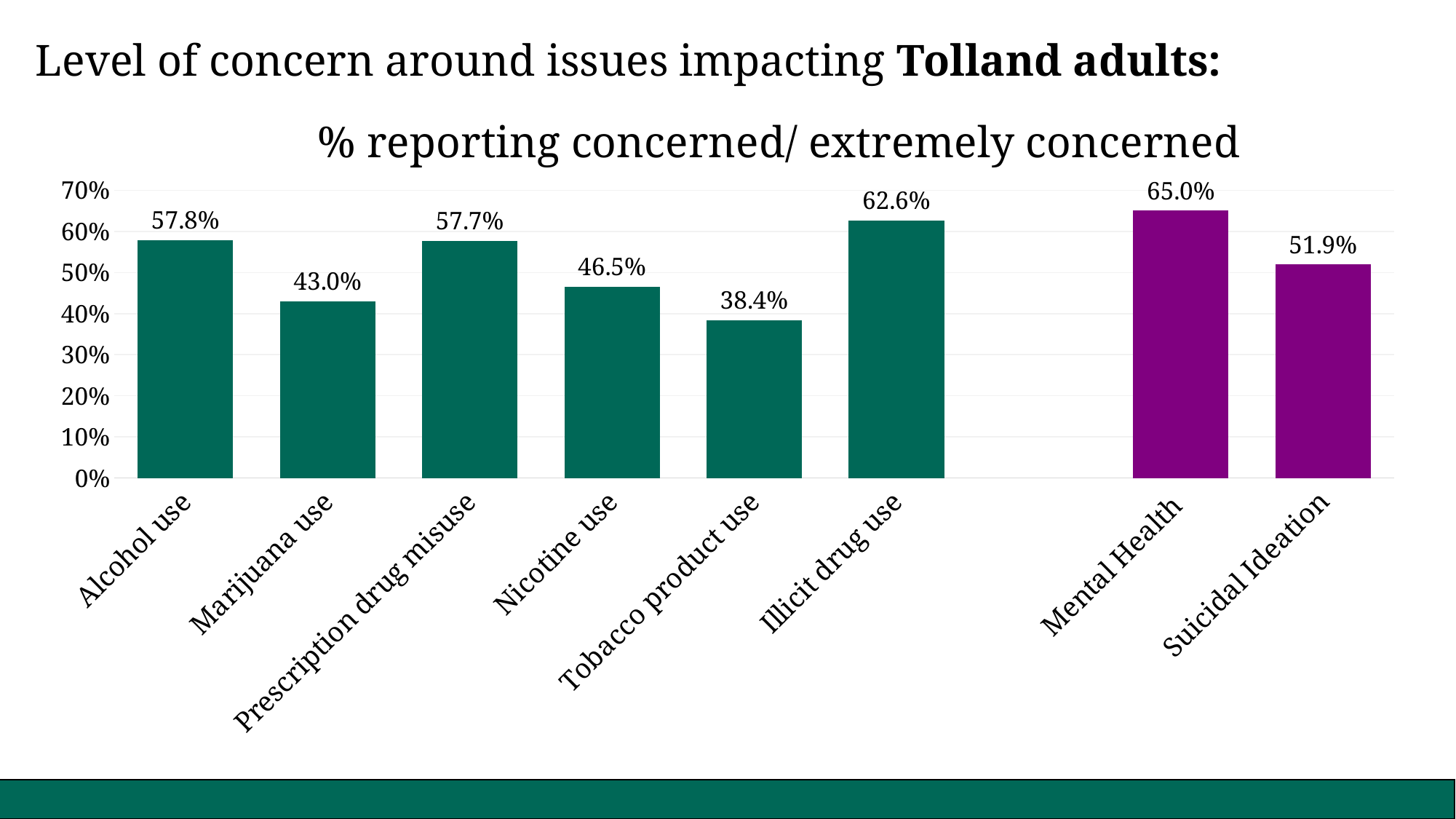
What percentage of Tolland adults reported being concerned or extremely concerned about Alcohol use? 57.8% What kind of chart is shown on the slide? Bar chart Which category has the highest percentage reporting concerned/extremely concerned? Mental Health Is the value for Illicit drug use greater or less than 60%? greater What is the difference between the values for Illicit drug use and Marijuana use? 19.6% Which category has the lowest percentage reporting concerned/extremely concerned? Tobacco product use What is the value shown for Mental Health? 65.0% How many categories are plotted on the chart? 8 Which two categories are shown in purple bars rather than green? Mental Health and Suicidal Ideation What is the chart's title? % reporting concerned/ extremely concerned What is the value shown for Tobacco product use? 38.4% Which is larger, the value for Nicotine use or the value for Suicidal Ideation? Suicidal Ideation